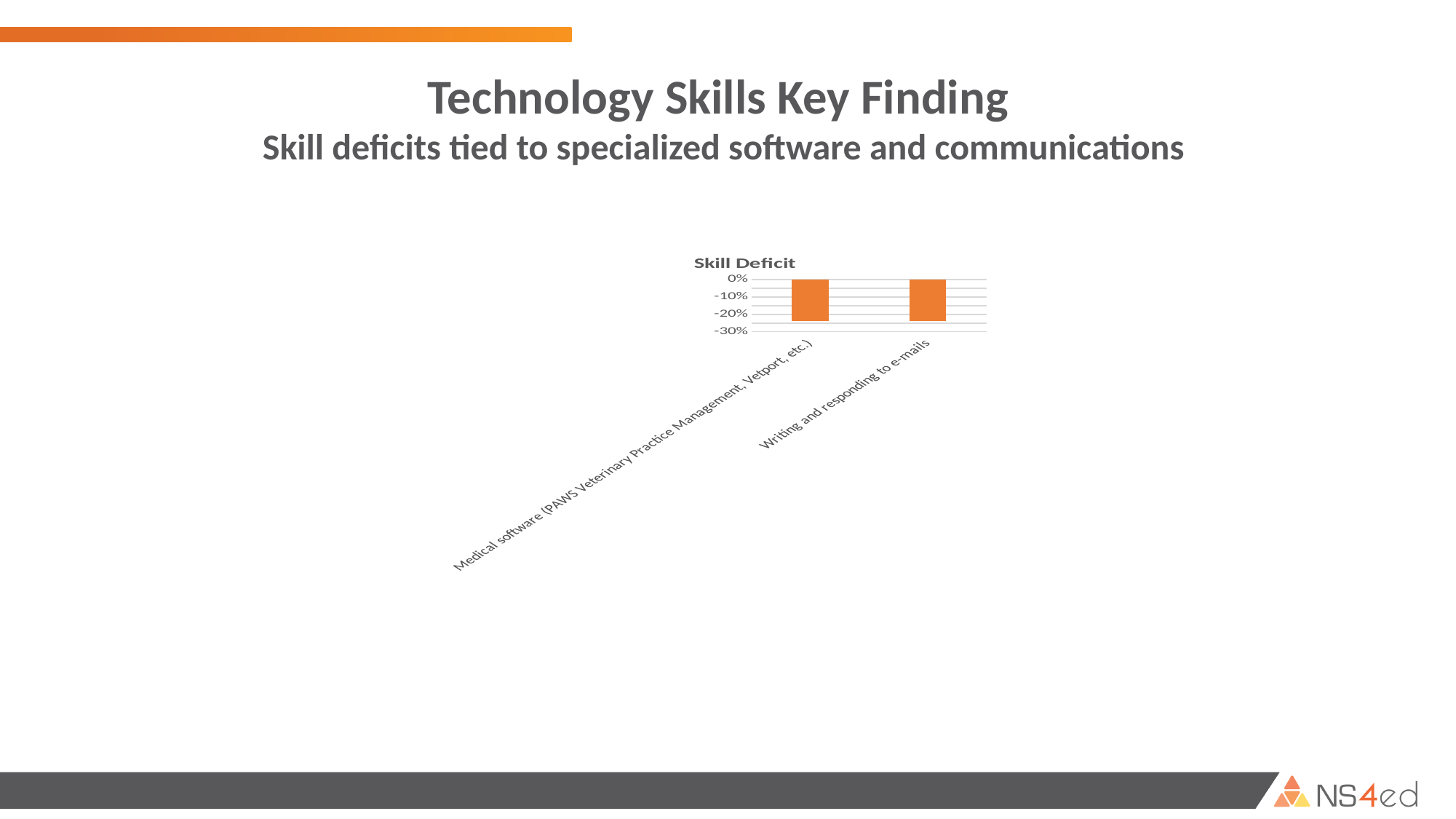
How many categories are plotted in the Skill Deficit chart? 2 What colour are the bars in the Skill Deficit chart? orange Is the value for Medical software (PAWS Veterinary Practice Management, Vetport, etc.) greater or less than -10%? less Is the value for Writing and responding to e-mails greater or less than -30%? greater What type of chart is shown on the slide? bar chart What is the title of the chart on the slide? Skill Deficit Is the value for Writing and responding to e-mails greater or less than -10%? less What is the lowest value shown on the vertical axis of the Skill Deficit chart? -30%